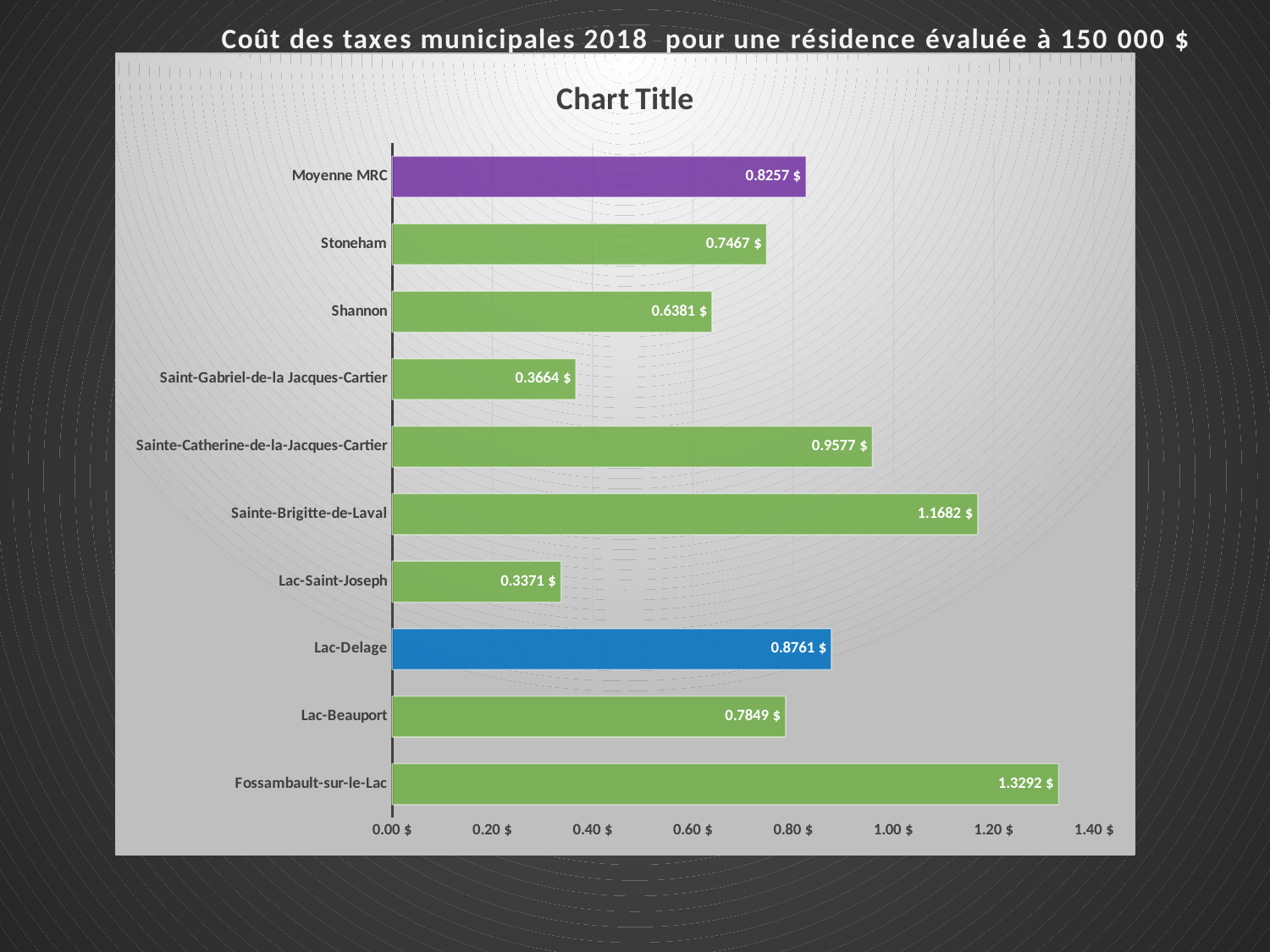
What is the value for Lac-Delage? 0.8761 $ Which is larger, the value for Stoneham or the value for Lac-Beauport? Lac-Beauport What is the value for Moyenne MRC? 0.8257 $ What is the difference between the values for Fossambault-sur-le-Lac and Lac-Saint-Joseph? 0.9921 $ Which category has the highest value? Fossambault-sur-le-Lac What is the value for Sainte-Brigitte-de-Laval? 1.1682 $ How many categories are shown in the chart? 10 Which category has the lowest value? Lac-Saint-Joseph What kind of chart is shown on the slide? bar chart What is the difference between the values for Lac-Delage and Moyenne MRC? 0.0504 $ Is the value for Sainte-Catherine-de-la-Jacques-Cartier greater or less than 0.80 $? greater Which bar is coloured blue? Lac-Delage